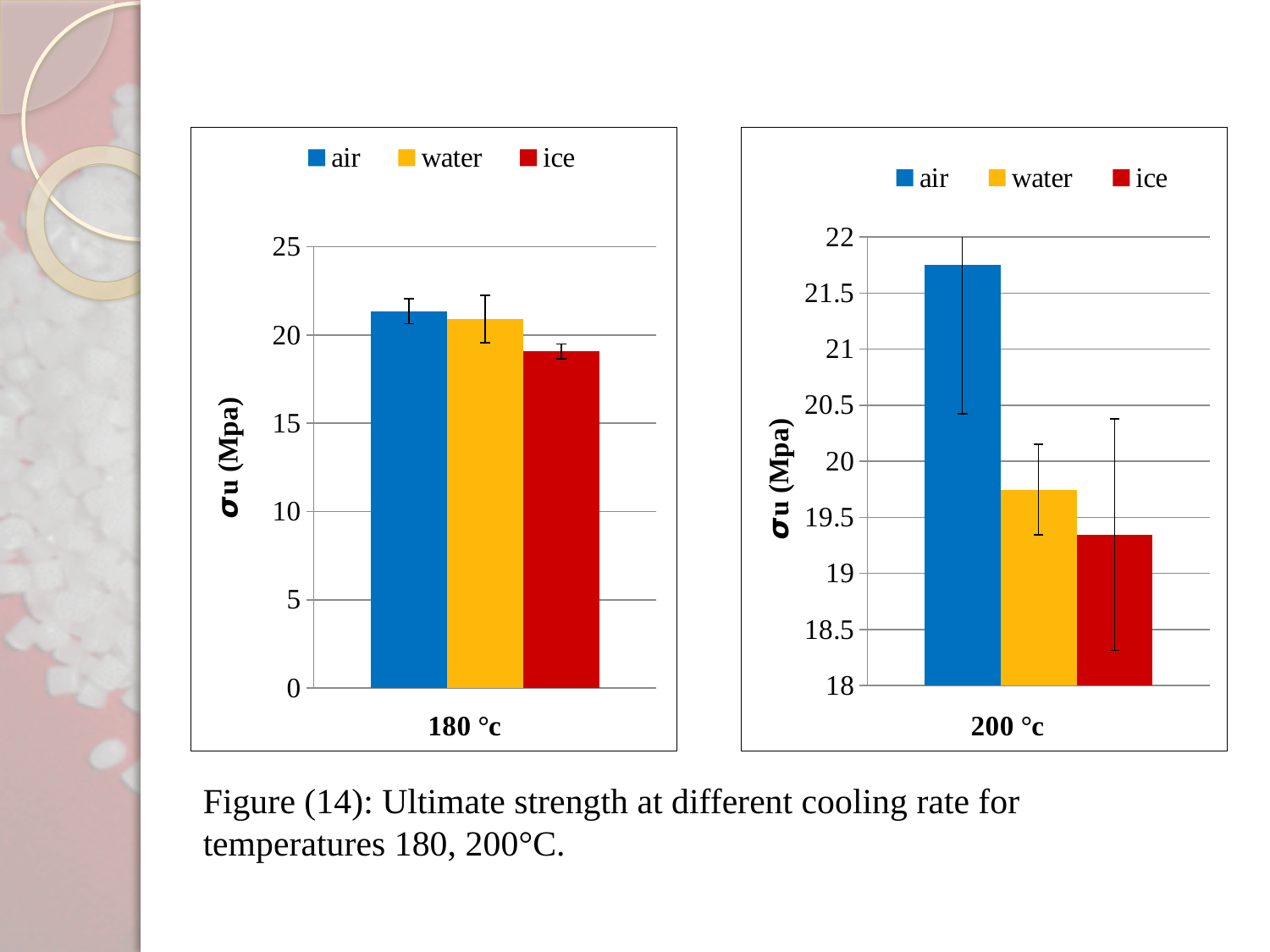
In the left chart (180 °c), is the value for ice greater or less than 20? less In the right chart (200 °c), which is larger, the value for air or the value for water? air What kind of chart is the left chart (180 °c)? bar chart What is the y-axis title of the right chart (200 °c)? σu (Mpa) In the right chart (200 °c), which series has the highest ultimate strength? air How many series does the legend of the right chart (200 °c) list? 3 In the right chart (200 °c), which series has the lowest ultimate strength? ice In the left chart (180 °c), which series has the lowest ultimate strength? ice In the left chart (180 °c), is the value for air greater or less than 20? greater In the right chart (200 °c), is the value for water greater or less than 20? less In the left chart (180 °c), which is larger, the value for air or the value for ice? air